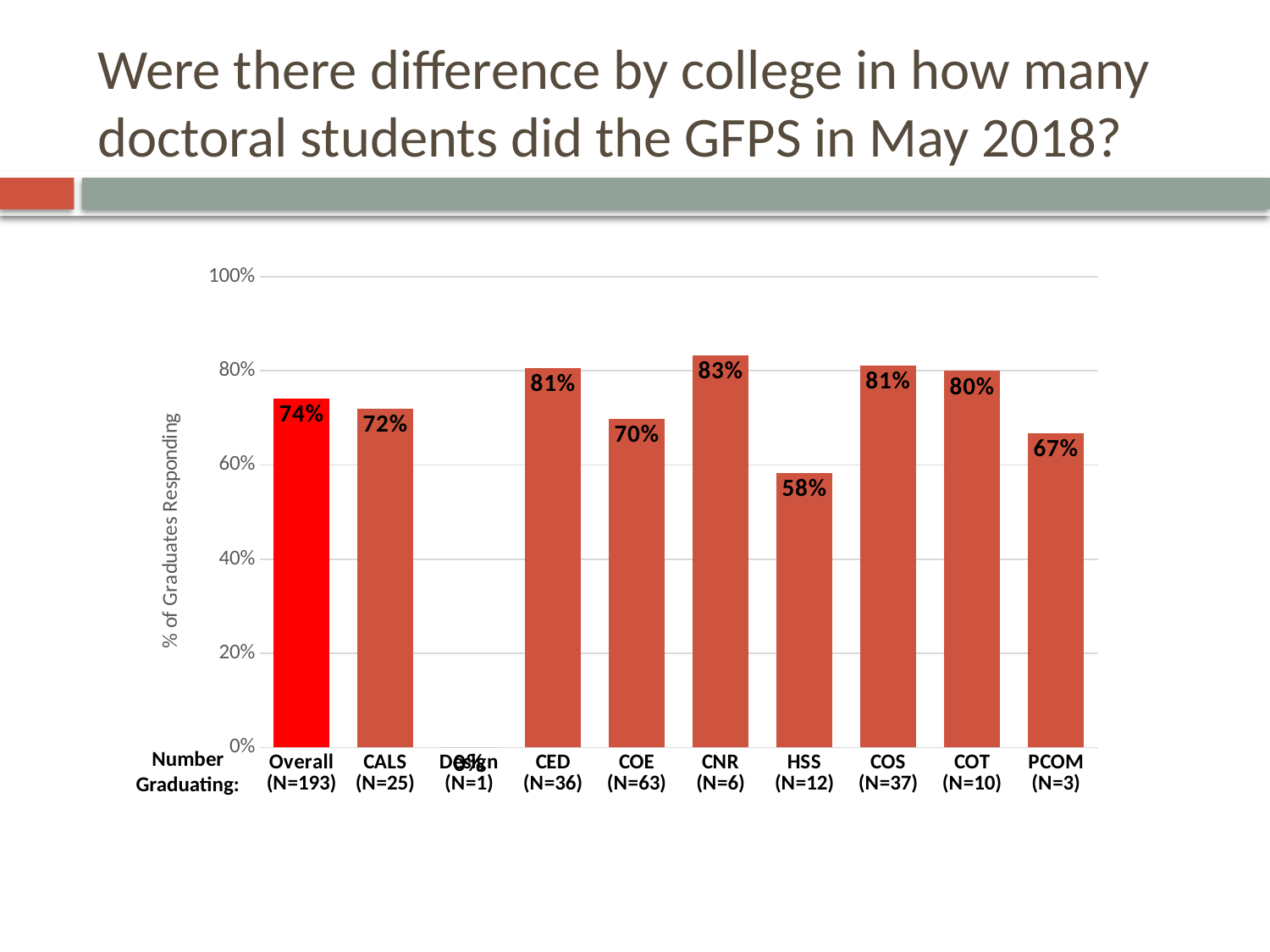
What is the percentage of graduates responding for PCOM (N=3)? 67% Which bar is shown in a different (bright red) colour from the others? Overall (N=193) How many categories (bars) are shown on the x axis? 10 What is the label on the vertical axis? % of Graduates Responding What is the difference in percentage points between CNR and HSS? 25 percentage points Is the value for HSS greater or less than 60%? less What type of chart is shown on the slide? Bar chart Which has a higher percentage of graduates responding, CED or COE? CED What is the percentage of graduates responding for HSS (N=12)? 58% What is the percentage of graduates responding for Overall (N=193)? 74% What is the percentage of graduates responding for COE (N=63)? 70% Which college has the highest percentage of graduates responding? CNR